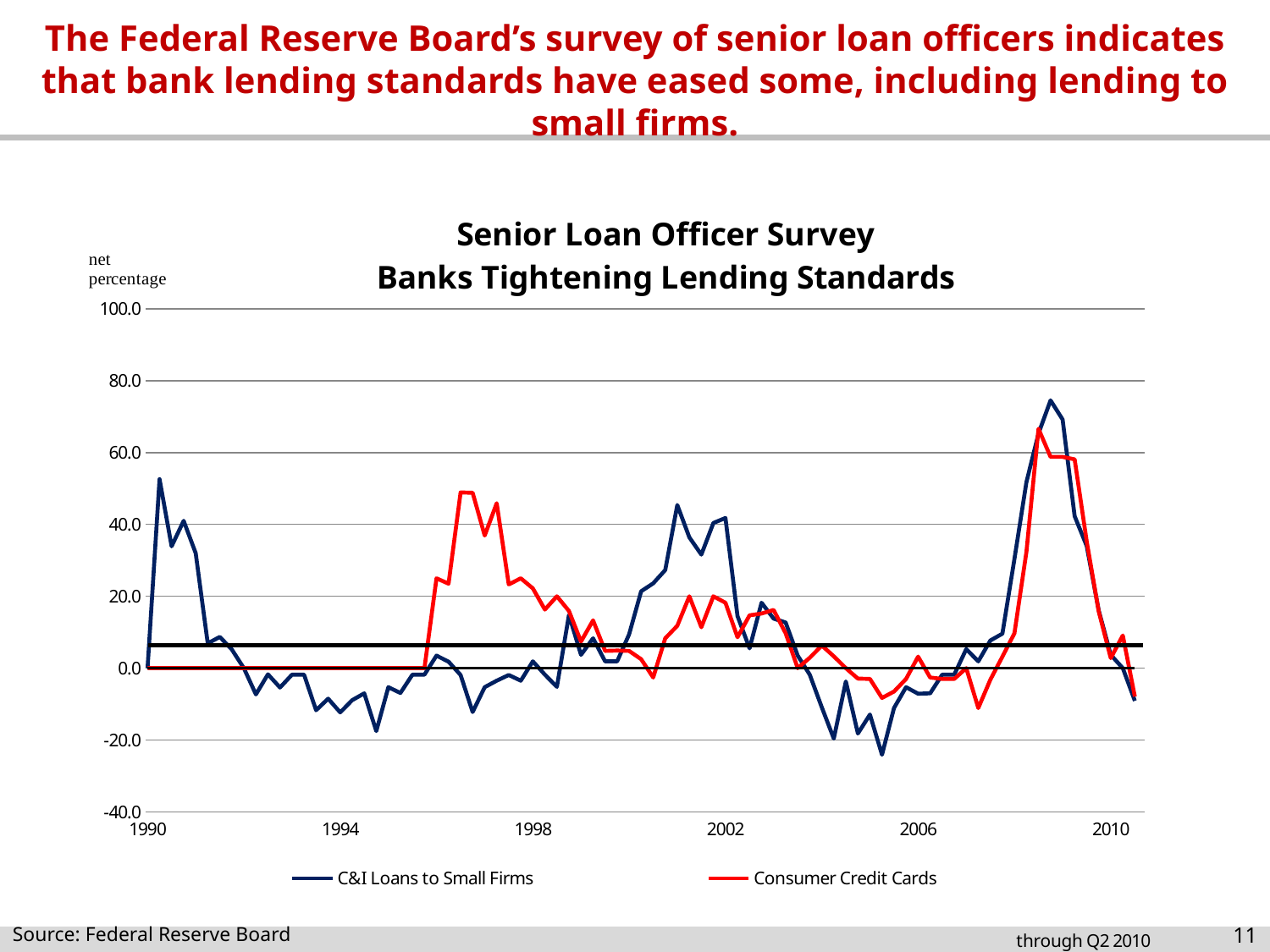
Is the peak value for C&I Loans to Small Firms around 2008-2009 greater or less than 60? greater Is the value for C&I Loans to Small Firms at its 1990 peak greater or less than 40? greater Do the values for C&I Loans to Small Firms rise or fall from their 2009 peak to 2010? fall Which series reaches the highest value anywhere on the chart? C&I Loans to Small Firms Is the lowest value for C&I Loans to Small Firms, around 2005, greater or less than -20? less What are the two series named in the legend? C&I Loans to Small Firms and Consumer Credit Cards Which series reaches the lowest value anywhere on the chart? C&I Loans to Small Firms What kind of chart is shown on the slide? Line chart How many series does the legend list? 2 What is the title of the chart? Senior Loan Officer Survey Banks Tightening Lending Standards